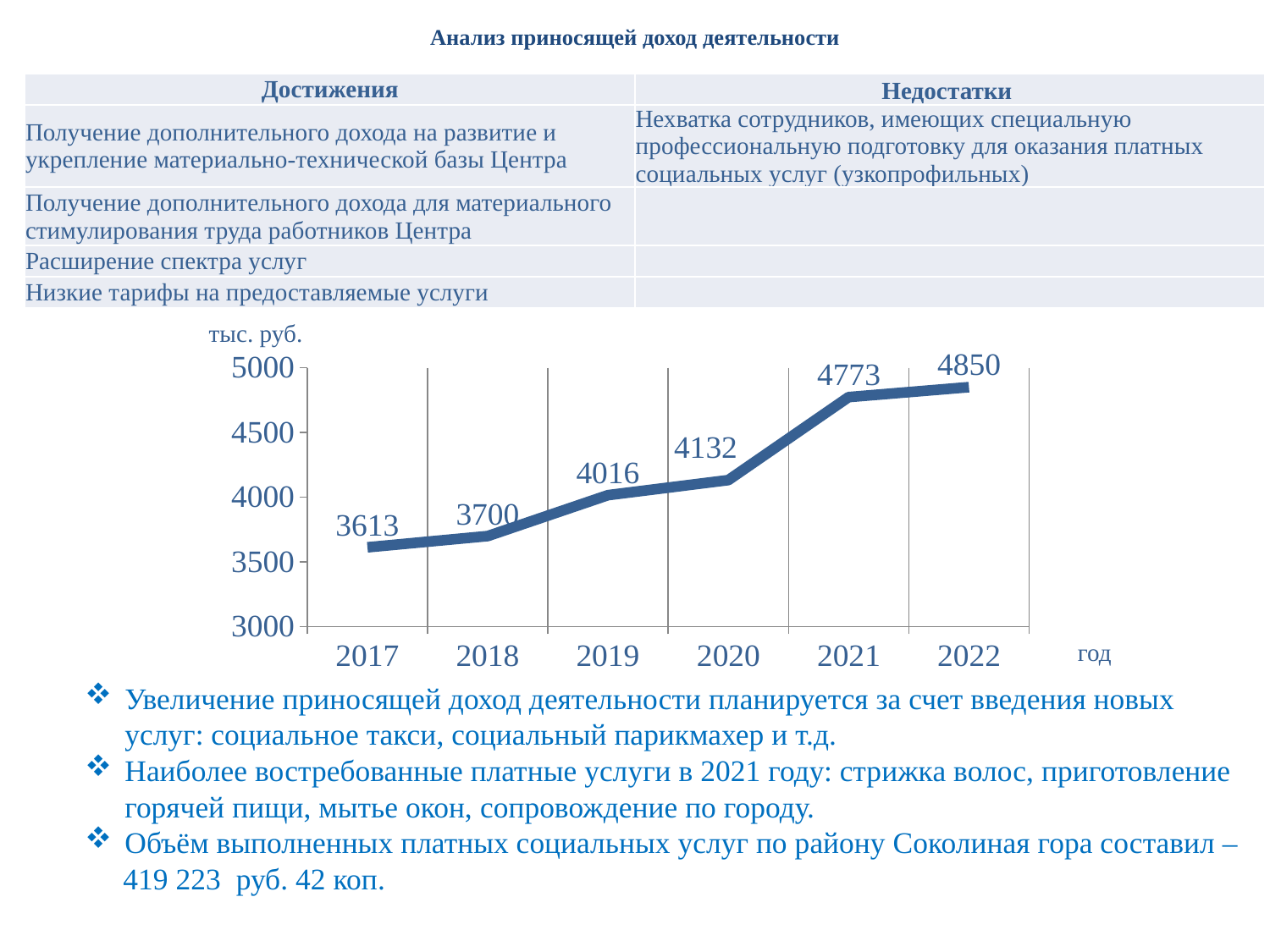
What kind of chart is shown on the slide? line chart How many years are plotted on the chart? 6 Which year has the lowest value? 2017 What is the value for 2020? 4132 Which is larger, the value for 2019 or the value for 2018? 2019 Which year has the highest value? 2022 What is the value for 2017? 3613 Is the value for 2021 greater or less than 4500? greater What is the value for 2022? 4850 Do the values rise or fall from 2017 to 2022? rise What is the difference between the values for 2022 and 2017? 1237 What is the difference between the values for 2021 and 2020? 641